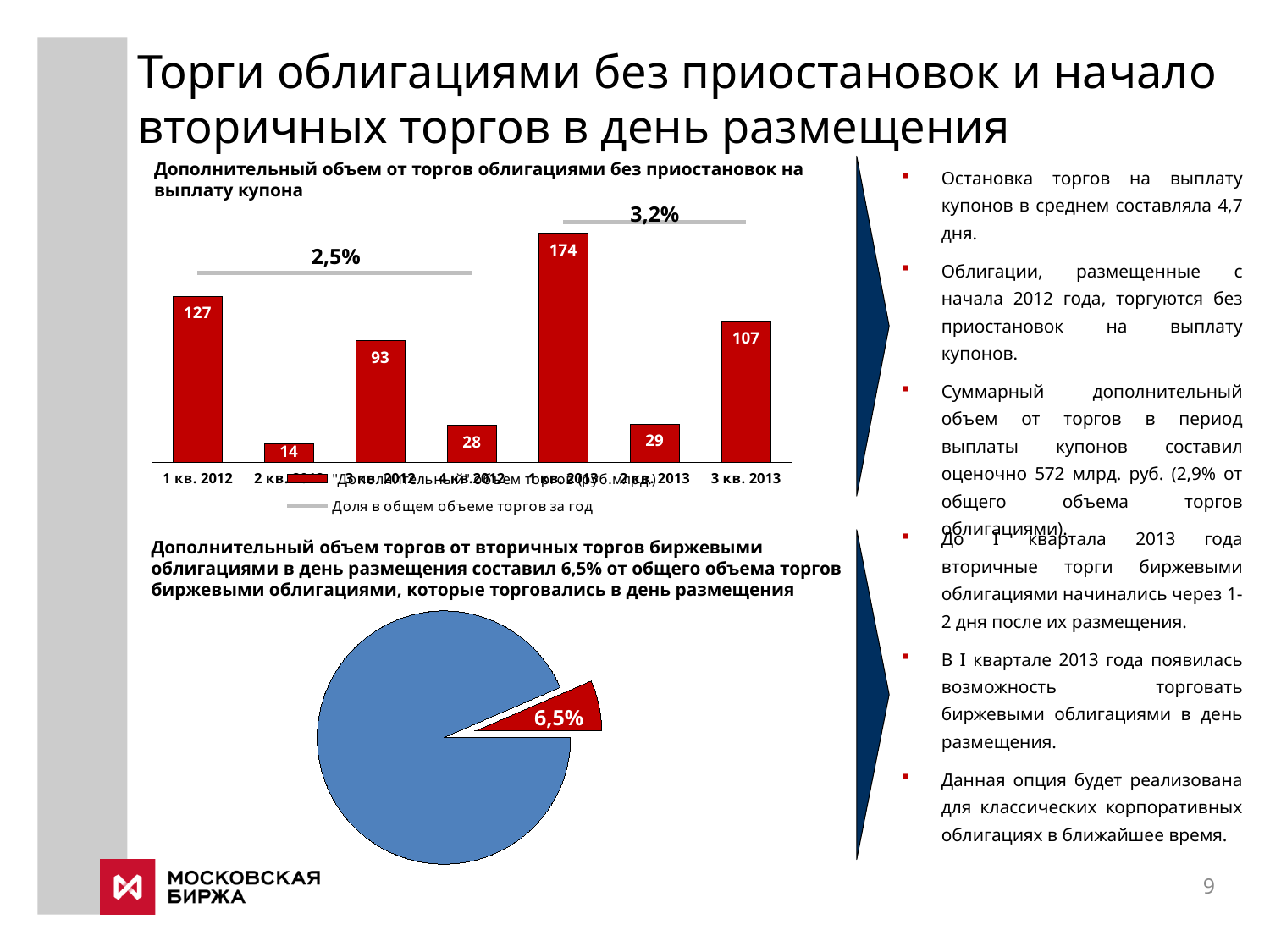
What kind of chart is the bottom chart on the slide? Pie chart In the top bar chart, what is the value of the highest bar? 174 In the top bar chart, which is larger: the value for 1 кв. 2012 or the value for 3 кв. 2013? 1 кв. 2012 In the top bar chart, what is the value for 1 кв. 2012? 127 In the top bar chart, what is the difference between the value for 1 кв. 2013 and the value for 1 кв. 2012? 47 How many series does the legend of the top chart list? 2 In the top chart, what share in the total trading volume is shown for 2013? 3,2% In the top bar chart, what is the value of the lowest bar? 14 In the top bar chart, which quarter has the highest bar? 1 кв. 2013 In the bottom pie chart, what share does the red slice represent? 6,5% In the top bar chart, what is the value for 3 кв. 2013? 107 How many bars are shown in the top bar chart? 7